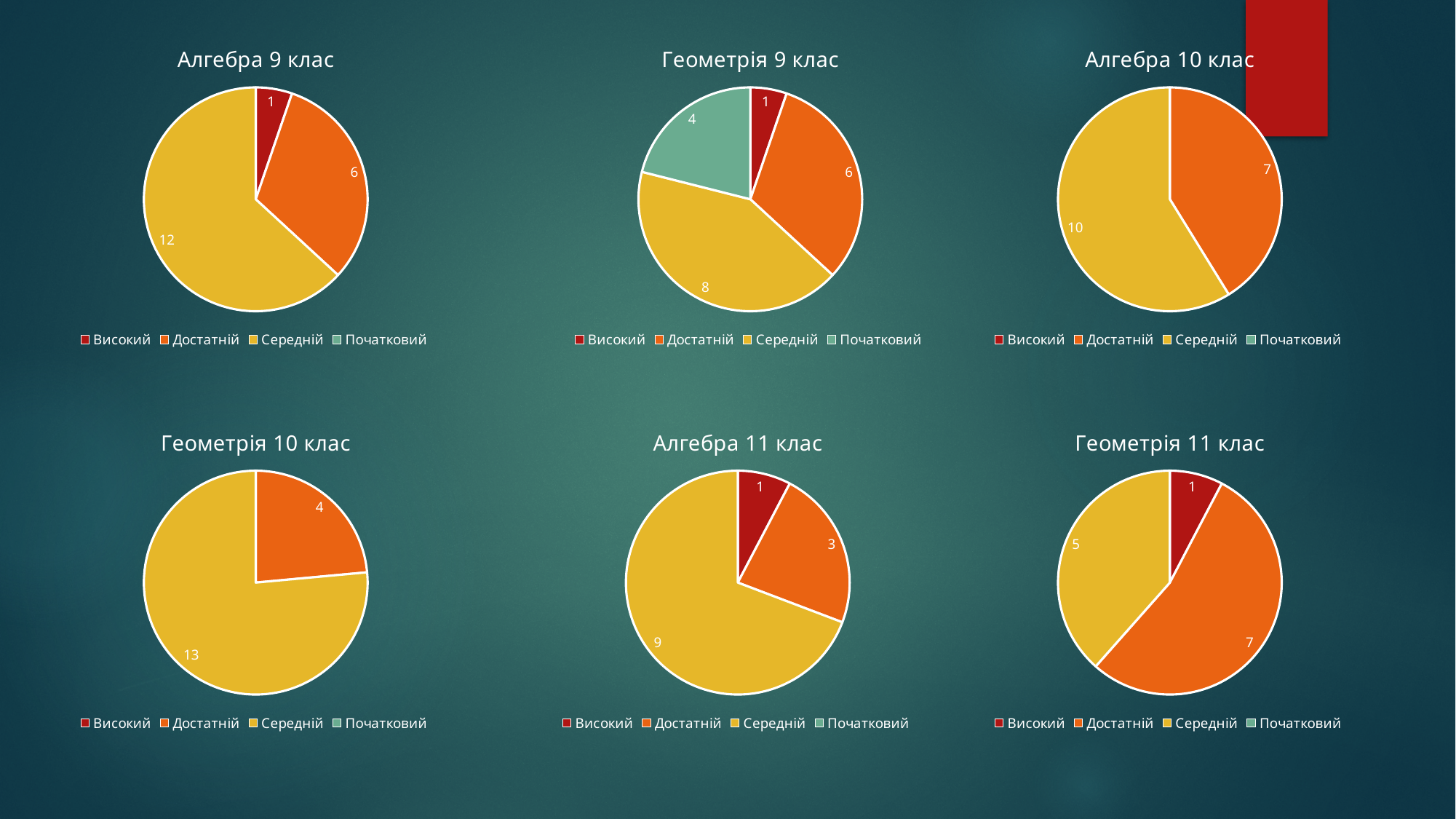
In the 'Алгебра 9 клас' chart, what is the value for Середній? 12 How many entries does the legend of the 'Геометрія 10 клас' chart list? 4 In the 'Геометрія 9 клас' chart, what is the value for Початковий? 4 How many slices does the 'Алгебра 10 клас' chart have? 2 In the 'Алгебра 11 клас' chart, which category has the smallest slice? Високий What is the total of all slices in the 'Алгебра 11 клас' chart? 13 How many slices does the 'Геометрія 9 клас' chart have? 4 In the 'Геометрія 10 клас' chart, what is the difference between Середній and Достатній? 9 What type of chart is 'Алгебра 9 клас'? Pie chart In the 'Геометрія 11 клас' chart, which category has the largest slice? Достатній In the 'Алгебра 10 клас' chart, what is the value for Достатній? 7 In the 'Геометрія 9 клас' chart, which is larger, Середній or Достатній? Середній